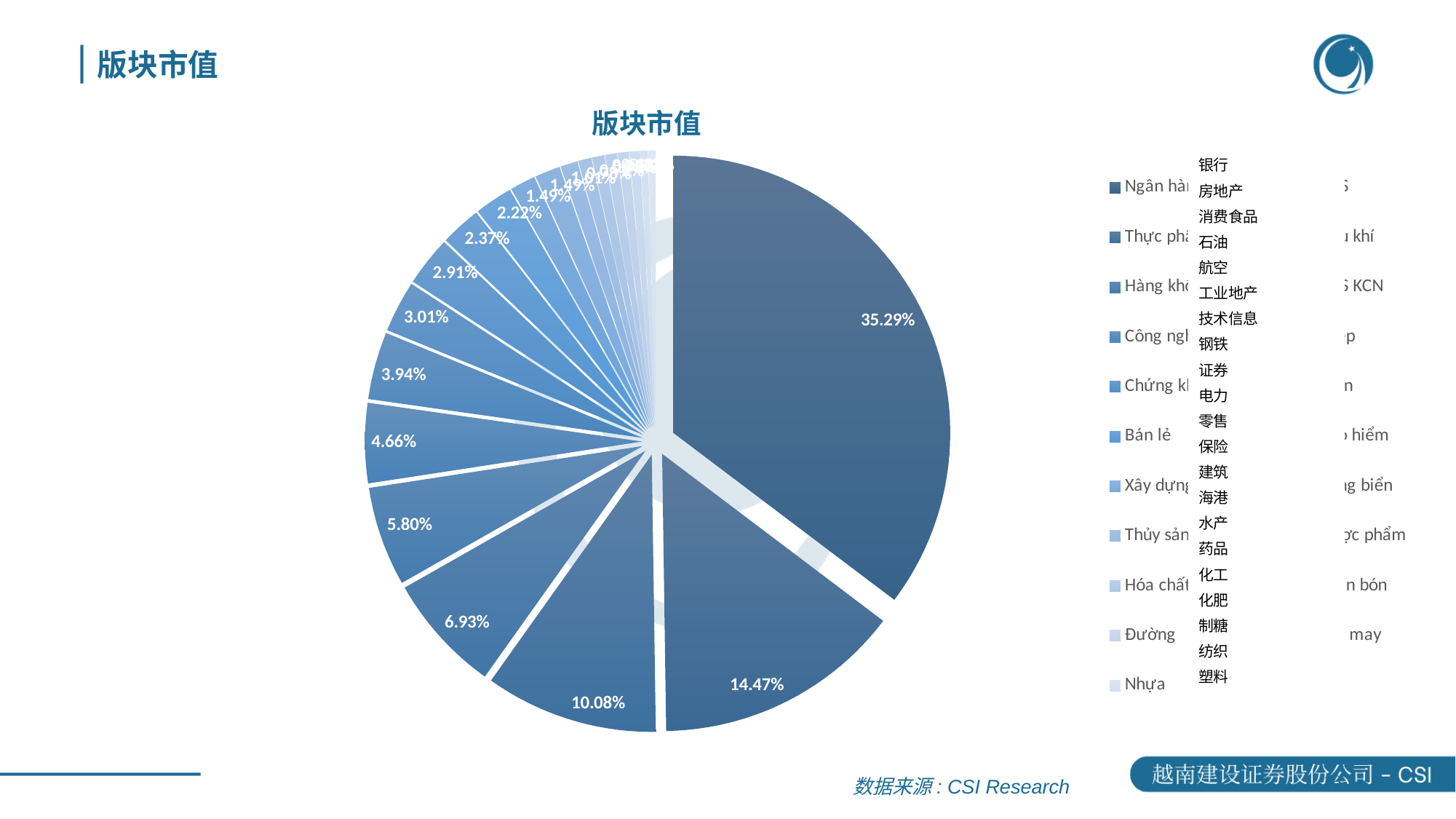
What is the share of the second-largest slice in the pie chart? 14.47% Which is larger, the slice labelled 6.93% or the slice labelled 5.80%? 6.93% What is the share of the third-largest slice in the pie chart? 10.08% How many sector entries are listed in the legend of the chart? 21 What is the title of the chart? 版块市值 What is the difference in percentage points between the 14.47% slice and the 10.08% slice? 4.39 percentage points What data source is cited below the chart? CSI Research What is the share of the largest slice in the pie chart? 35.29% What kind of chart is shown on the slide? pie chart What is the combined share of the three largest slices (35.29%, 14.47% and 10.08%)? 59.84% What is the difference in percentage points between the largest slice (35.29%) and the second-largest slice (14.47%)? 20.82 percentage points What is the share of the fourth-largest slice in the pie chart? 6.93%